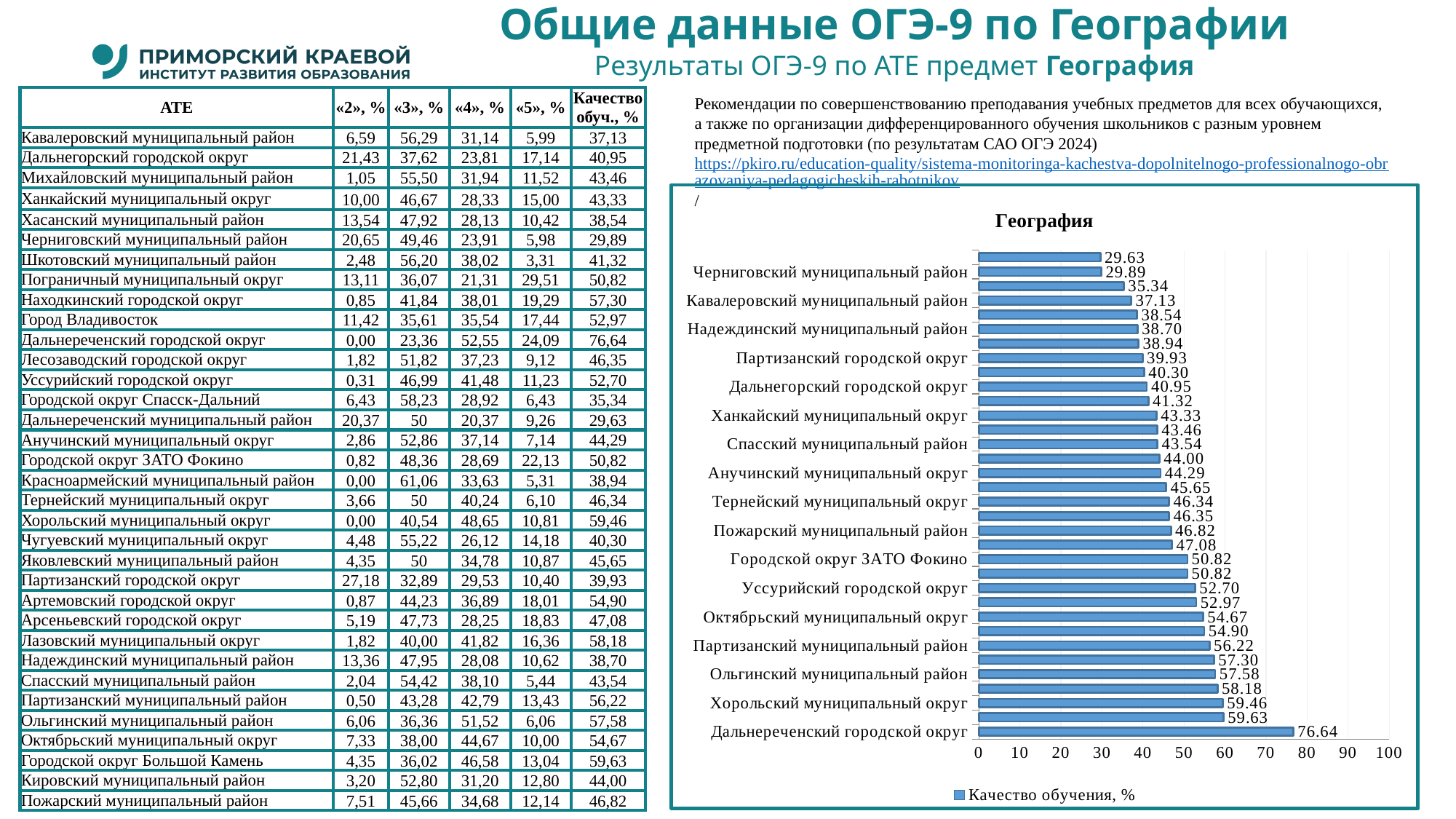
Which category has the highest value in the chart? Дальнереченский городской округ What is the value for Уссурийский городской округ in the chart? 52.70 What is the value for Дальнереченский городской округ in the chart? 76.64 What is the difference between the values for Дальнереченский городской округ and Хорольский муниципальный округ? 17.18 What type of chart is shown on the slide? bar chart How many bars are plotted in the chart? 34 What is the legend entry of the chart? Качество обучения, % What is the value for Хорольский муниципальный округ in the chart? 59.46 How many series does the chart legend list? 1 What is the title of the chart on the right side of the slide? География Which is larger in the chart: the value for Кавалеровский муниципальный район or the value for Ханкайский муниципальный округ? Ханкайский муниципальный округ What is the value for Черниговский муниципальный район in the chart? 29.89